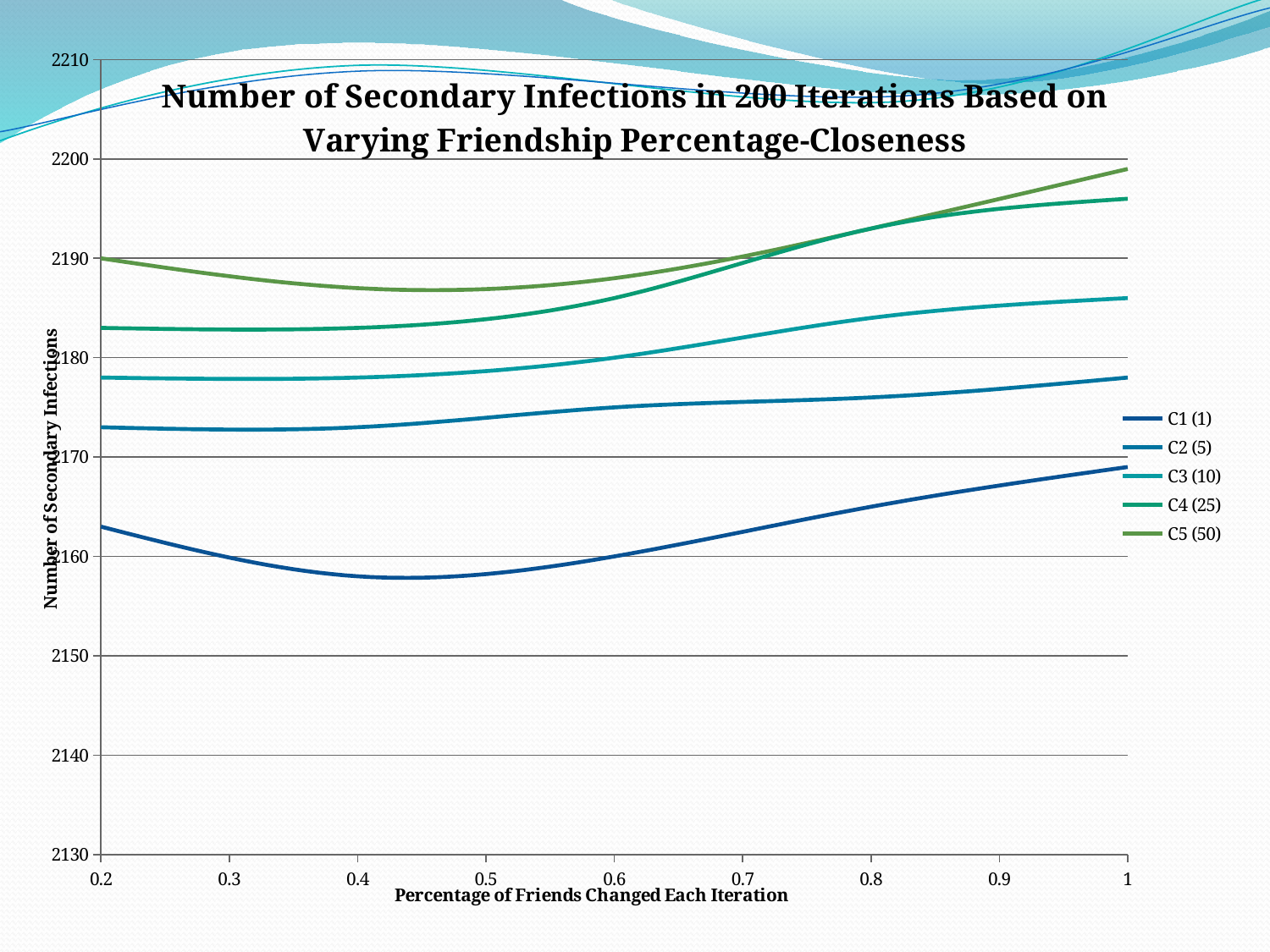
Is the value for C4 (25) at x = 1 greater or less than 2190? greater Which series has the highest value at x = 0.2? C5 (50) At x = 0.6, which series has the larger value, C2 (5) or C3 (10)? C3 (10) How many series does the legend list? 5 What is the title of the chart? Number of Secondary Infections in 200 Iterations Based on Varying Friendship Percentage-Closeness What kind of chart is shown on the slide? line chart Which series has the lowest value at x = 0.2? C1 (1) Is the value for C5 (50) at x = 0.2 greater or less than 2180? greater Is the value for C1 (1) at x = 0.2 greater or less than 2160? greater Does the C1 (1) series rise or fall between x = 0.6 and x = 1? rise Which series has the lowest value at x = 1? C1 (1) What is the label of the x axis? Percentage of Friends Changed Each Iteration